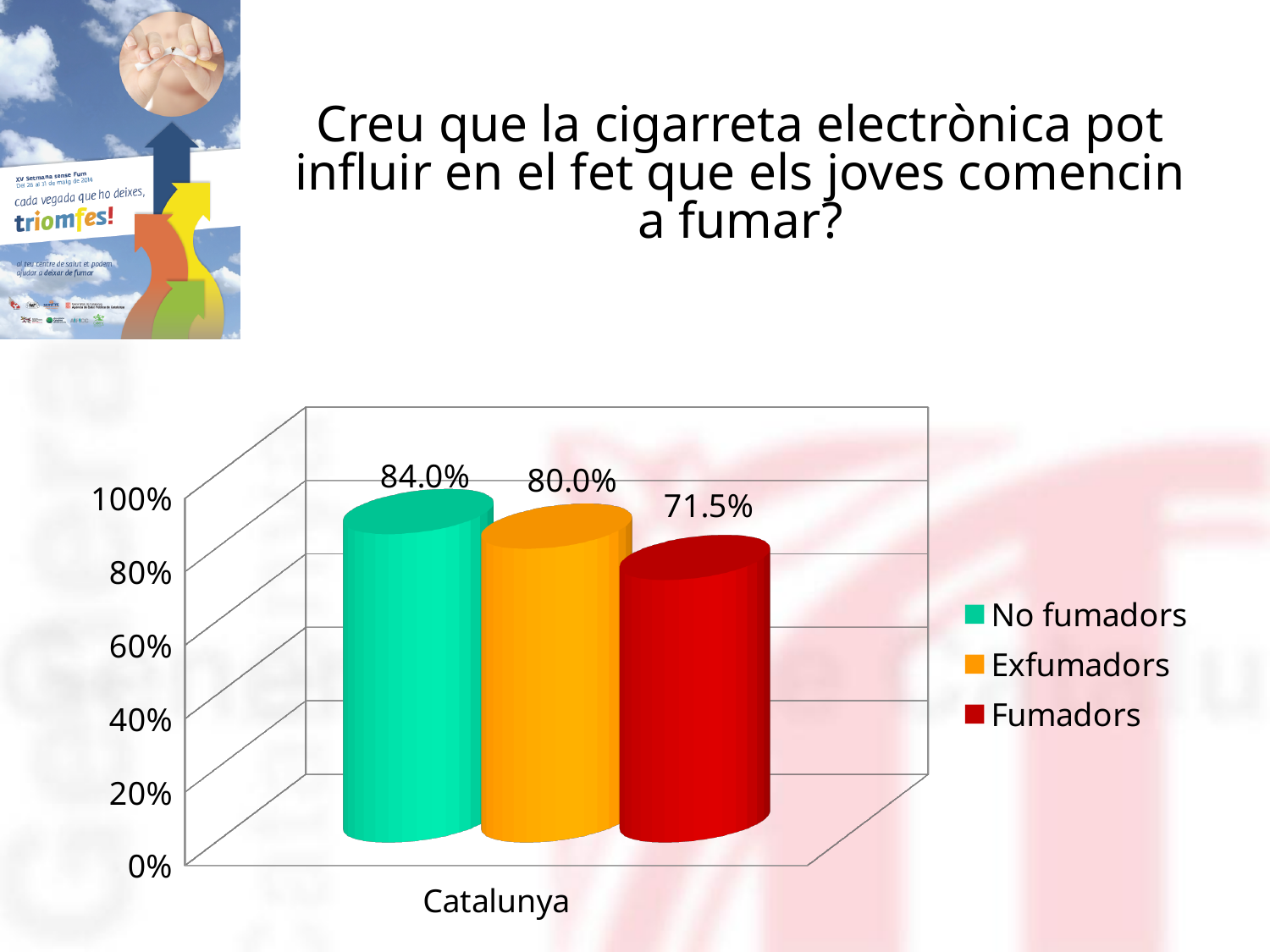
Which is larger, the value for Exfumadors or the value for Fumadors? Exfumadors Which series has the highest value? No fumadors What is the value for Exfumadors? 80.0% How many series does the legend list? 3 What is the value for Fumadors? 71.5% Which series has the lowest value? Fumadors What is the difference between the values for No fumadors and Fumadors? 12.5% Is the value for Fumadors greater or less than 80%? less What is the difference between the values for No fumadors and Exfumadors? 4.0% What is the category label shown on the x axis? Catalunya What is the value for No fumadors? 84.0% What kind of chart is shown on the slide? bar chart